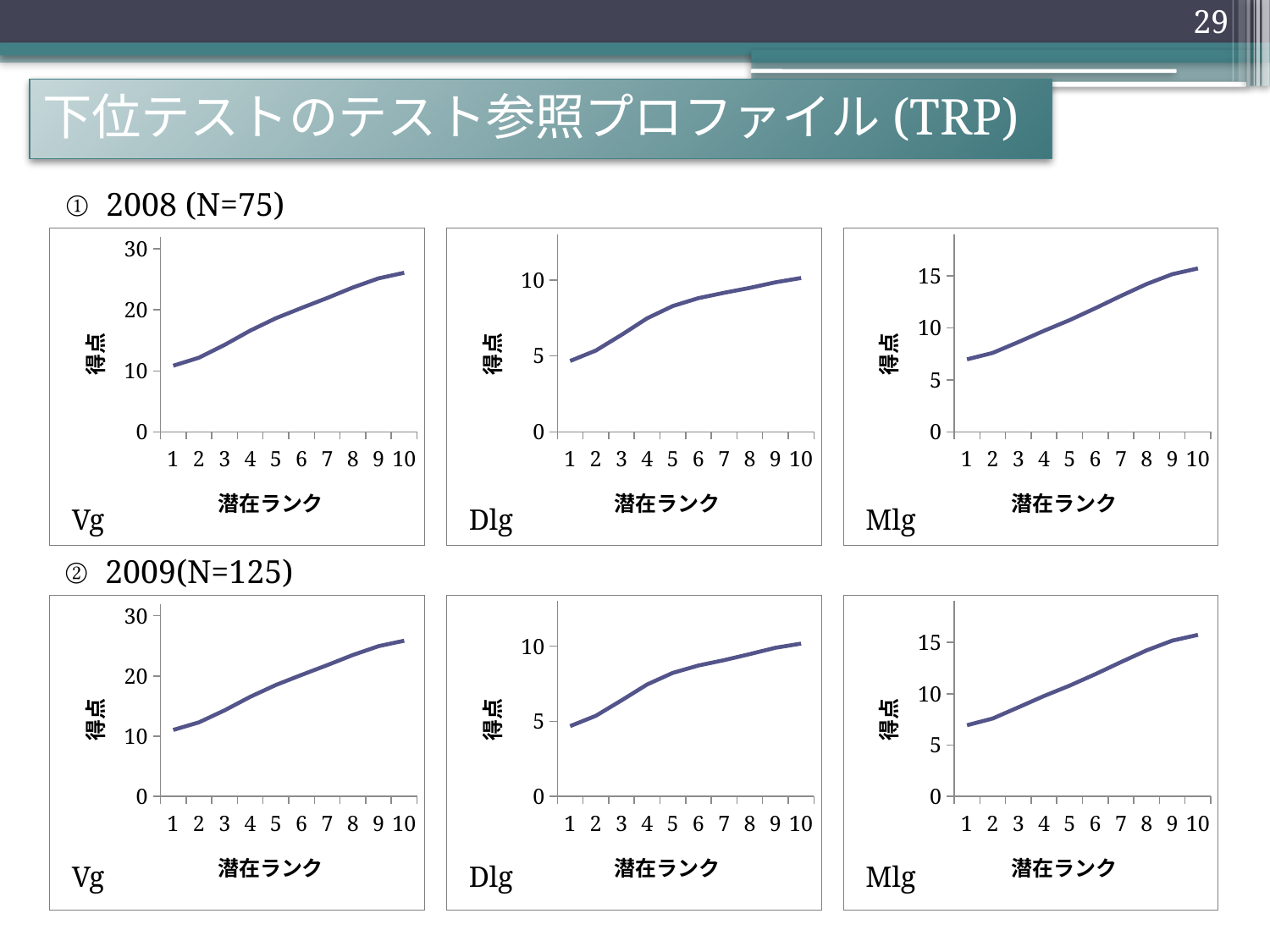
What is the x-axis title of the 2008 Mlg chart (top right)? 潜在ランク What is the y-axis title of the 2009 Vg chart (bottom left)? 得点 In the 2009 Dlg chart (bottom middle), which 潜在ランク has the lowest 得点 value? 1 In the 2008 Dlg chart (top middle), is the value at 潜在ランク 10 greater or less than 5? greater In the 2008 Vg chart (top left), is the value at 潜在ランク 10 greater or less than 20? greater In the 2008 Vg chart (top left), is the value at 潜在ランク 1 greater or less than 20? less In the 2009 Vg chart (bottom left), which 潜在ランク has the highest 得点 value? 10 How many 潜在ランク points are plotted along the x axis of the 2009 Dlg chart (bottom middle)? 10 What kind of chart is the 2008 Vg chart (top left)? line chart In the 2008 Vg chart (top left), do the values rise or fall as 潜在ランク increases from 1 to 10? rise